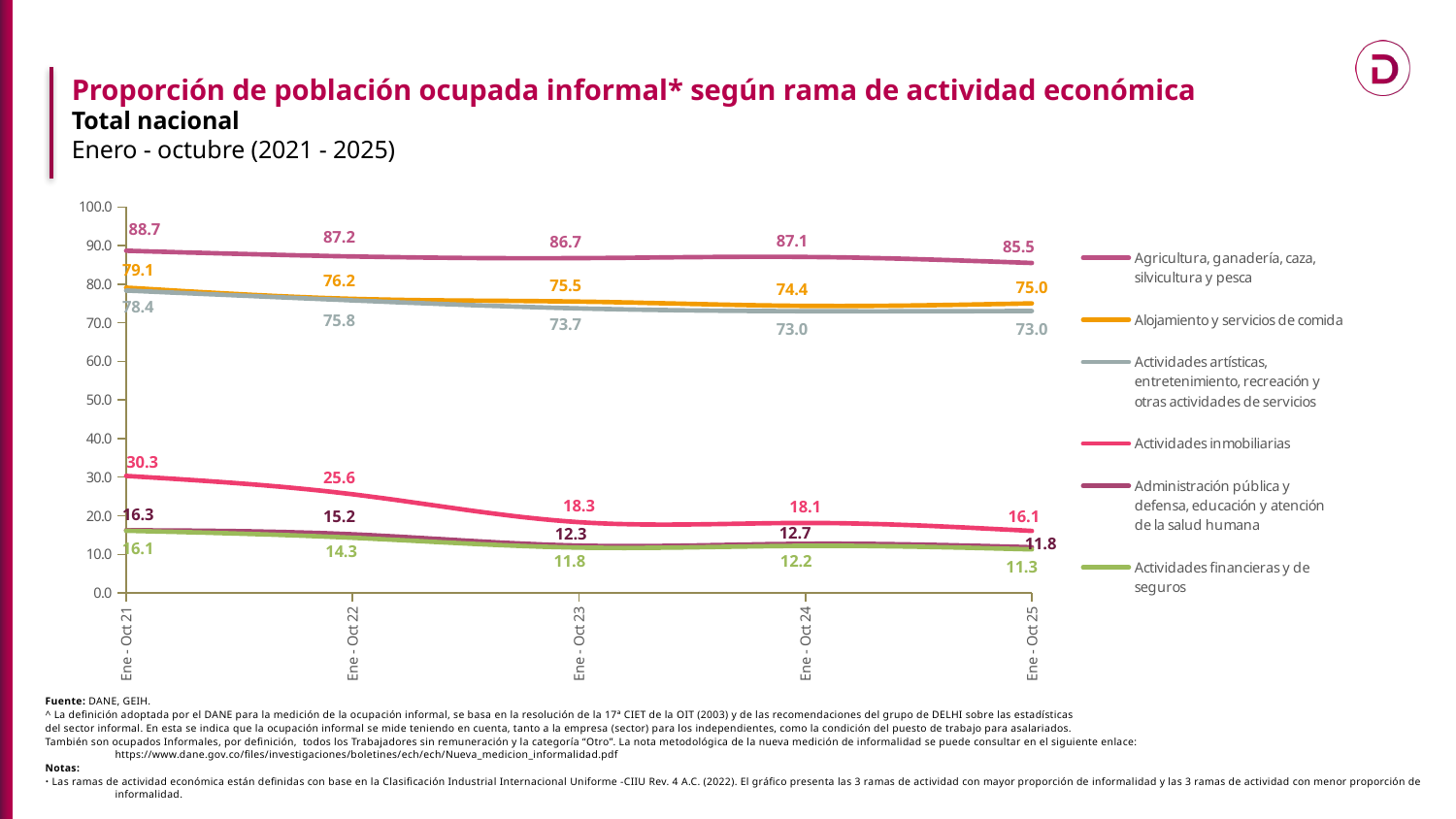
What is the value for Agricultura, ganadería, caza, silvicultura y pesca in Ene - Oct 25? 85.5 Which series has the lowest value in Ene - Oct 25? Actividades financieras y de seguros How many series does the legend list? 6 What is the difference between the Agricultura, ganadería, caza, silvicultura y pesca value in Ene - Oct 21 and in Ene - Oct 25? 3.2 What type of chart is shown on the slide? Line chart What is the value for Actividades inmobiliarias in Ene - Oct 21? 30.3 What is the subtitle shown under the chart title? Total nacional Which is larger in Ene - Oct 22: Alojamiento y servicios de comida or Actividades artísticas, entretenimiento, recreación y otras actividades de servicios? Alojamiento y servicios de comida How many periods are shown on the x axis? 5 Does the value for Actividades inmobiliarias rise or fall from Ene - Oct 21 to Ene - Oct 25? Fall What is the value for Actividades financieras y de seguros in Ene - Oct 23? 11.8 Which series has the highest value in Ene - Oct 24? Agricultura, ganadería, caza, silvicultura y pesca